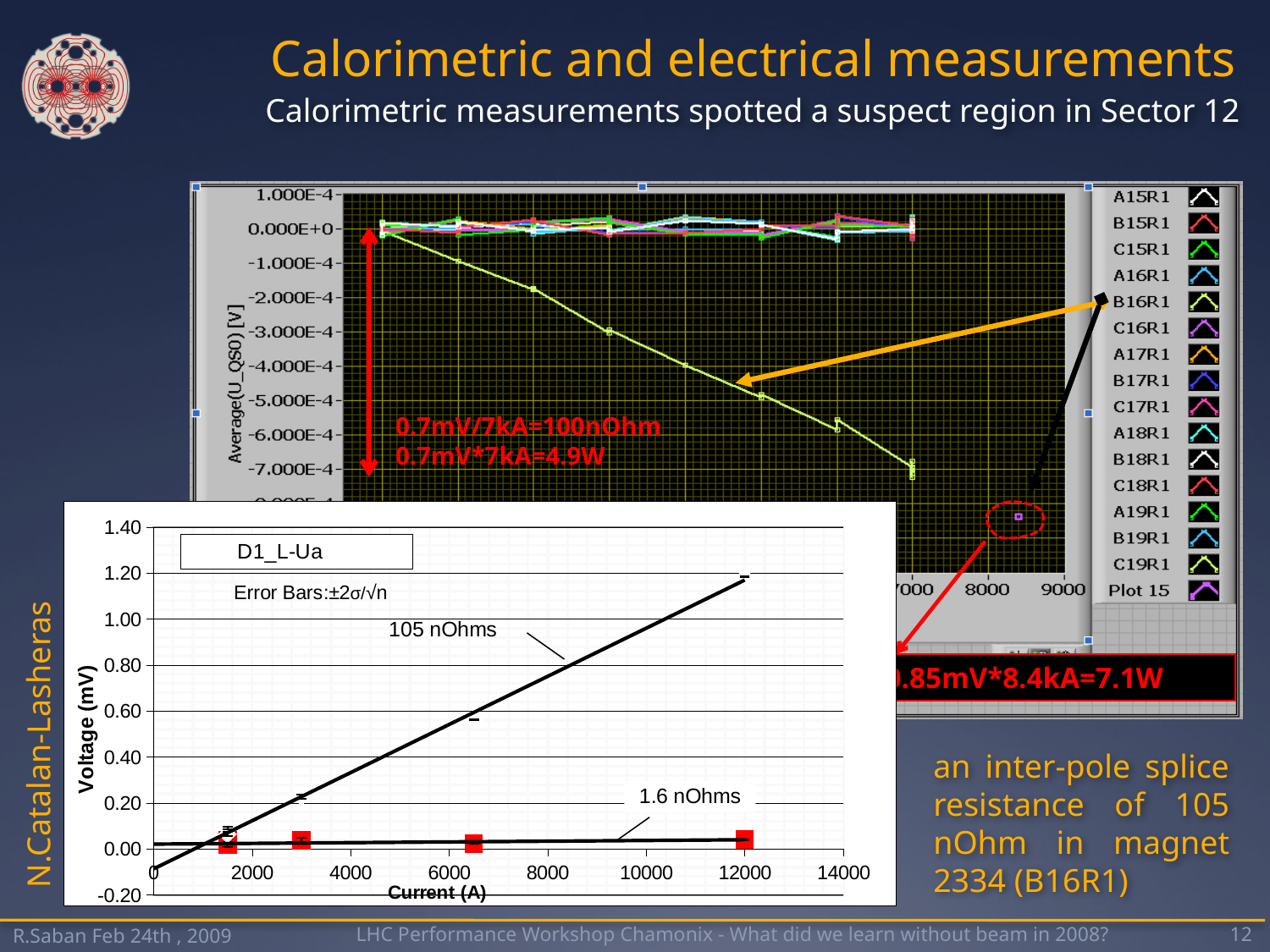
In the top chart, does the green line that separates from the others rise or fall as current increases? fall In the top chart, is the lowest point of the descending green line greater or less than -6.000E-4 V? less What kind of chart is the bottom chart titled D1_L-Ua? line chart In the bottom chart (D1_L-Ua), what resistance value labels the nearly flat line? 1.6 nOhms In the bottom chart (D1_L-Ua), is the voltage of the 105 nOhms line at 12000 A greater or less than 1.00 mV? greater In the bottom chart (D1_L-Ua), what resistance value labels the steeply rising line? 105 nOhms How many entries does the legend of the top chart list? 16 In the bottom chart (D1_L-Ua), what is the label of the y axis? Voltage (mV) In the bottom chart (D1_L-Ua), at 12000 A, which line has the higher voltage, 105 nOhms or 1.6 nOhms? 105 nOhms In the top chart, which legend entry does the orange arrow point to? B16R1 In the bottom chart (D1_L-Ua), does the 105 nOhms line rise or fall as current increases? rise In the bottom chart (D1_L-Ua), what does the note about error bars say? Error Bars:±2σ/√n